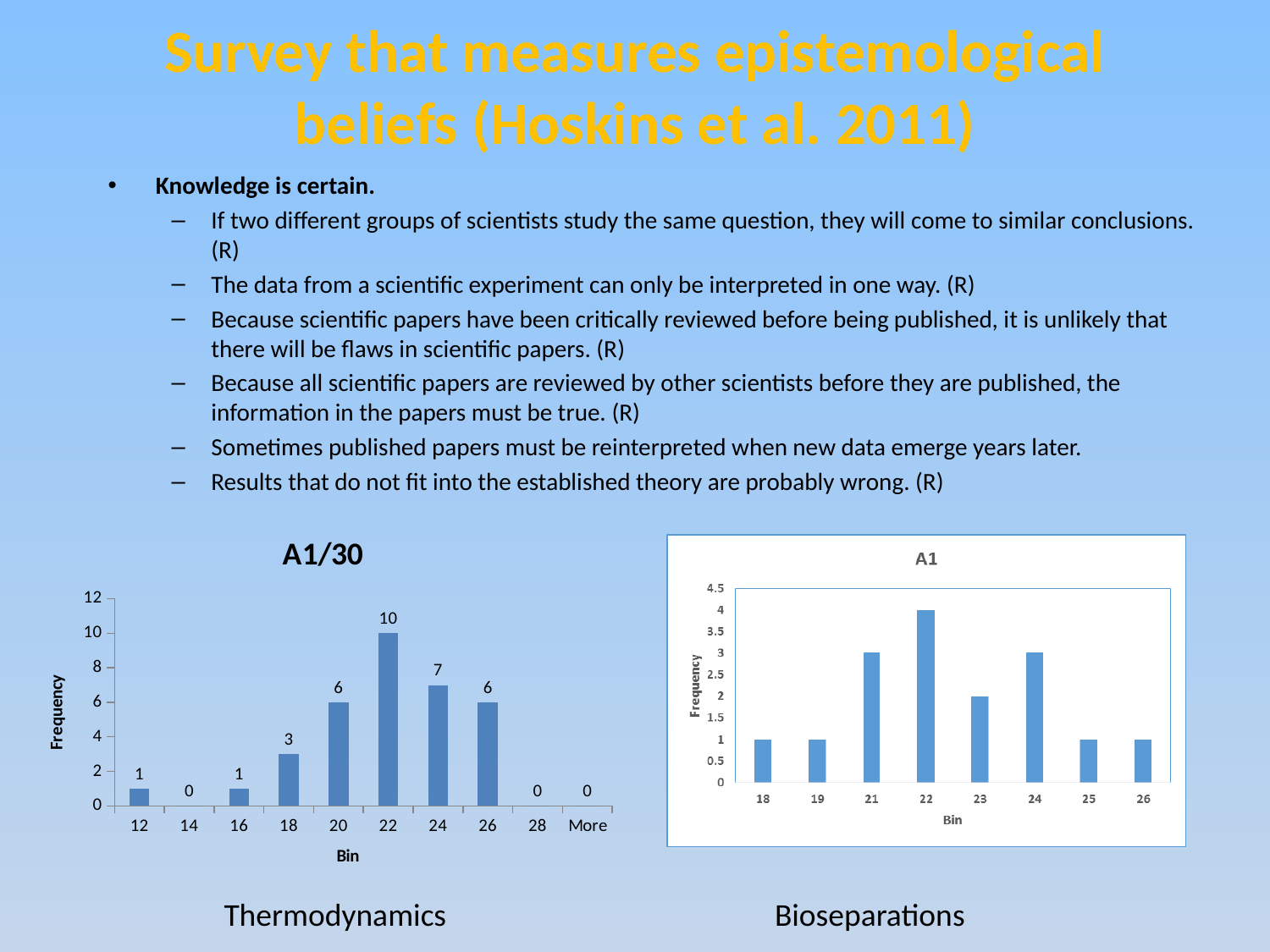
What kind of chart is the A1 chart on the right? Bar chart In the A1/30 chart, how many bins have a frequency of 0? 3 In the A1 chart on the right, which bin has the highest frequency? 22 In the A1/30 chart, what is the frequency for bin 18? 3 In the A1 chart on the right, what is the frequency for bin 22? 4 In the A1 chart on the right, how many bins are shown on the x axis? 8 In the A1/30 chart, what is the frequency for bin 22? 10 In the A1/30 chart, what is the difference between the frequencies for bins 22 and 24? 3 In the A1/30 chart, how many bins are shown on the x axis? 10 What is the x-axis title of the A1/30 chart? Bin In the A1/30 chart, which bin has the highest frequency? 22 In the A1/30 chart, which has the larger frequency, bin 20 or bin 24? 24